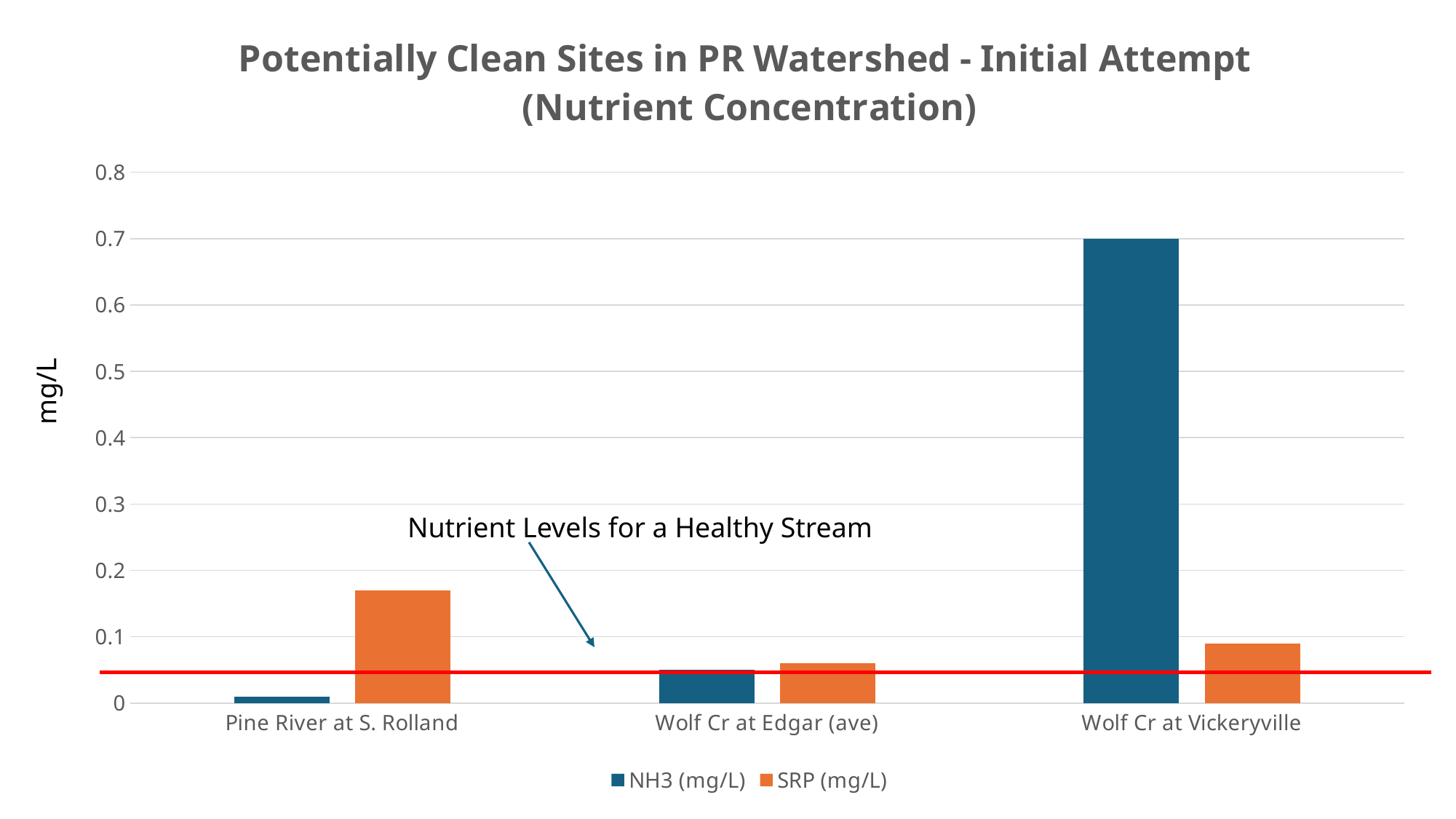
Is the NH3 (mg/L) value for Wolf Cr at Edgar (ave) greater or less than 0.1? less What does the red horizontal line on the chart represent? Nutrient Levels for a Healthy Stream Which is larger at Pine River at S. Rolland, the NH3 (mg/L) value or the SRP (mg/L) value? SRP (mg/L) Which site has the lowest NH3 (mg/L) value? Pine River at S. Rolland Which is larger at Wolf Cr at Vickeryville, the NH3 (mg/L) value or the SRP (mg/L) value? NH3 (mg/L) Is the SRP (mg/L) value for Pine River at S. Rolland greater or less than 0.1? greater What kind of chart is shown on the slide? bar chart What is the NH3 (mg/L) value for Wolf Cr at Vickeryville? 0.7 How many series does the legend list? 2 Which site has the highest NH3 (mg/L) value? Wolf Cr at Vickeryville Which site has the highest SRP (mg/L) value? Pine River at S. Rolland How many sites are shown on the x axis? 3